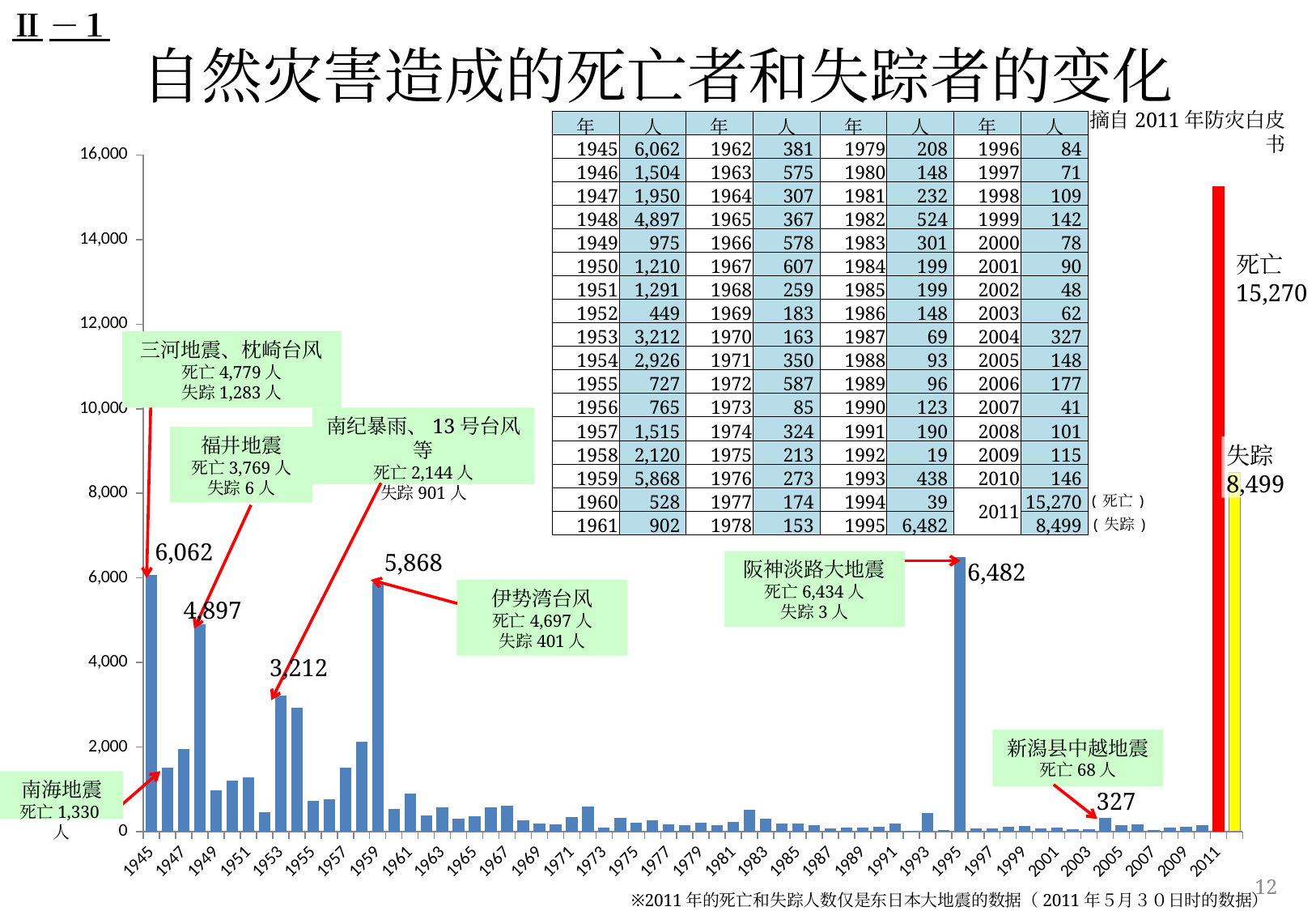
What is the difference between the values for 1995 and 1945? 420 Which is larger, the value for 1948 or the value for 1953? 1948 What kind of chart is shown on the slide? bar chart Which year has the tallest bar on the chart? 2011 Is the value for 1946 greater or less than 2,000? less What is the value labelled on the bar for 1959? 5,868 What is the value labelled on the bar for 2004? 327 What is the number of deaths (死亡) shown for 2011? 15,270 What is the number of missing (失踪) shown for 2011? 8,499 What is the difference between the 2011 deaths (死亡) and the 2011 missing (失踪) values? 6,771 What is the value shown for 1945 on the chart? 6,062 What is the value labelled on the bar for 1995? 6,482